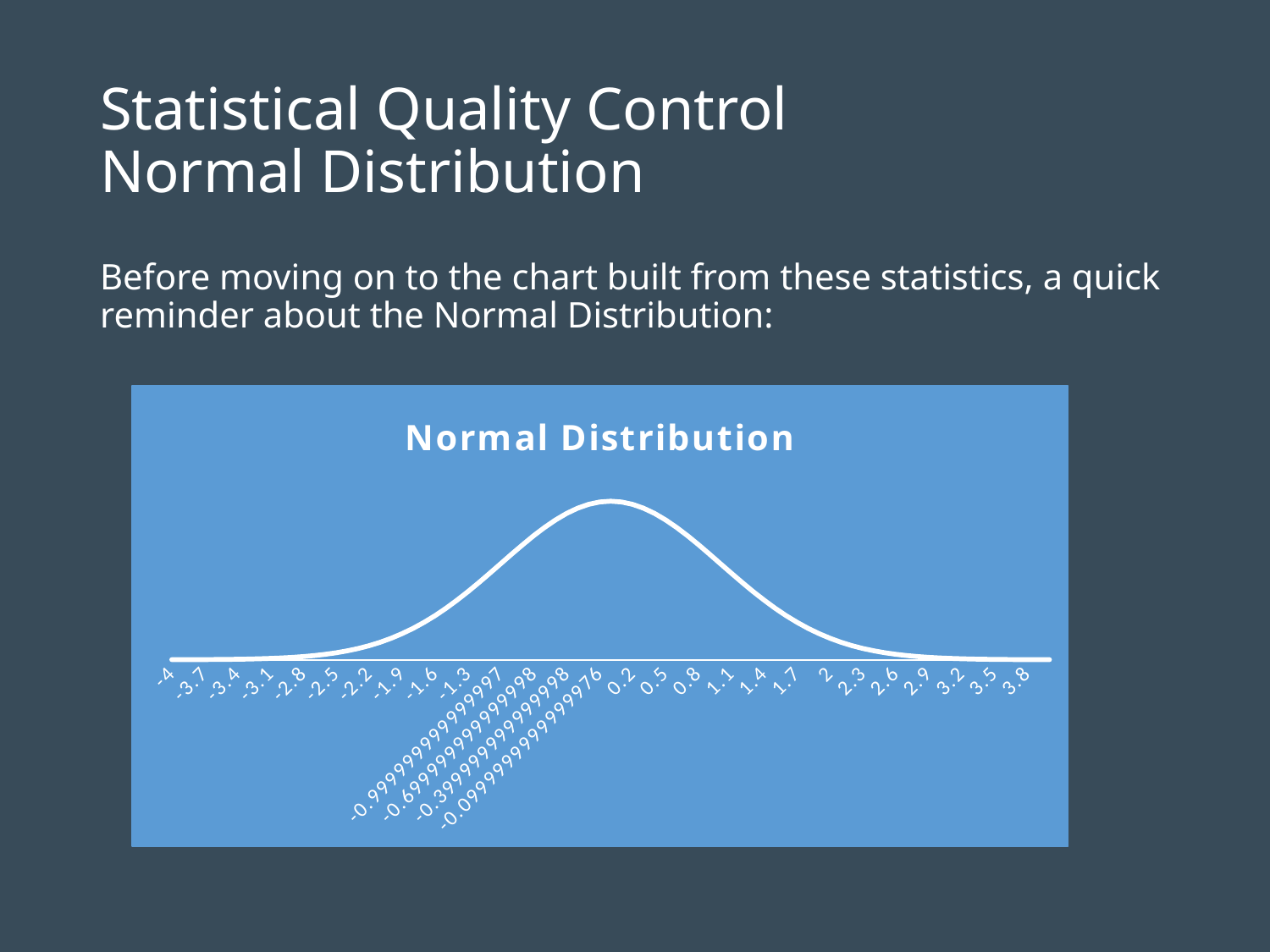
Which is higher on the curve, the value at x = -1.3 or the value at x = 0.2? 0.2 Which is higher on the curve, the value at x = 0.5 or the value at x = 2.9? 0.5 What is the title of the chart? Normal Distribution Does the curve rise or fall as the x axis moves from 0.5 toward 3.8? Falls What colour is the plotted line in the chart? White What kind of chart is shown on the slide? Line chart How many labels are shown along the x axis? 27 What is the rightmost label on the x axis? 3.8 What is the leftmost label on the x axis? -4 Does the curve rise or fall as the x axis moves from -4 toward 0? Rises Which is lower on the curve, the value at x = -3.1 or the value at x = -0.0999999999999976? -3.1